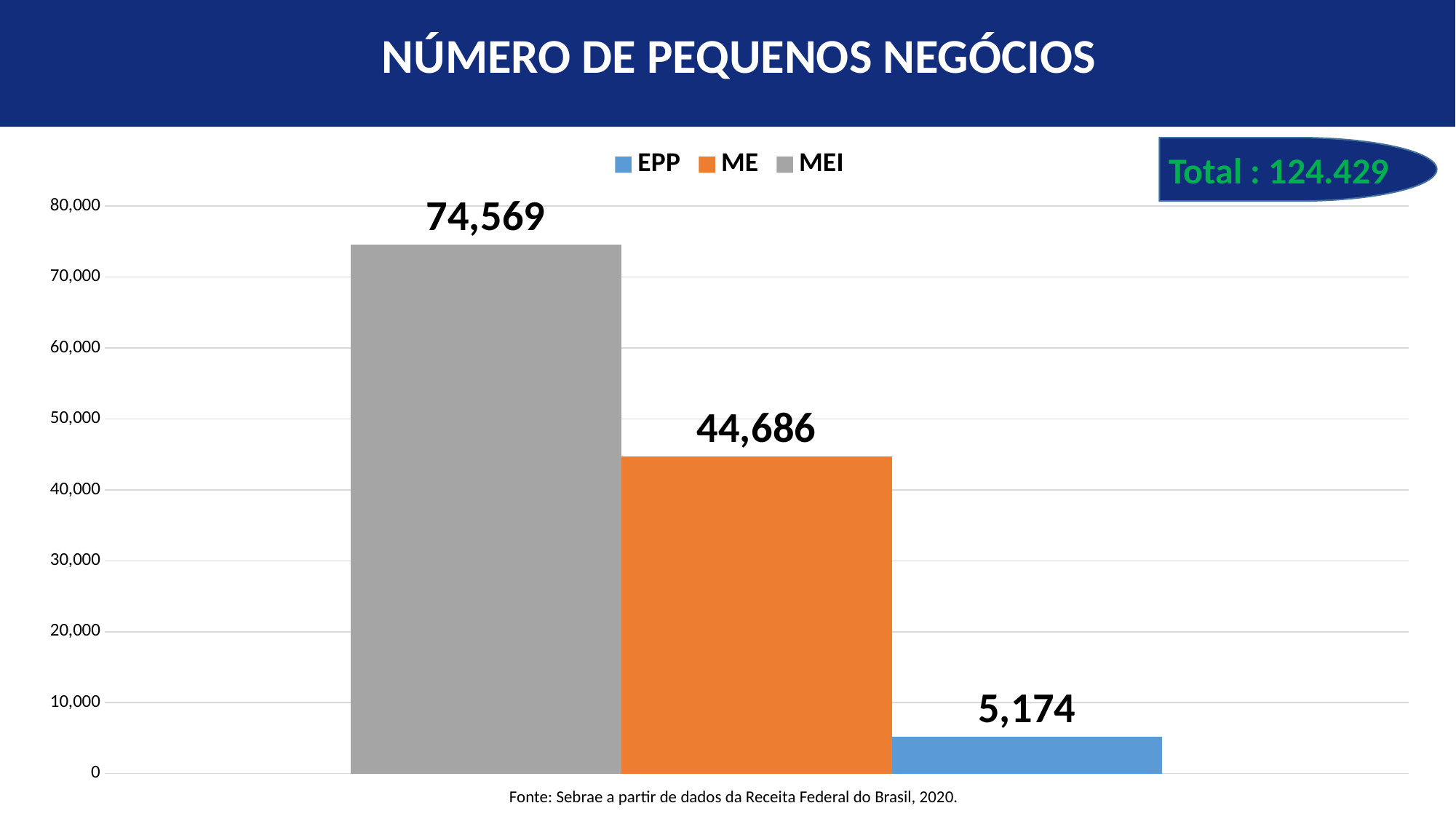
What is the difference between the values for MEI and ME? 29,883 What is the difference between the values for ME and EPP? 39,512 How many series does the legend list? 3 Which series has the highest value? MEI Which is larger, the value for ME or the value for EPP? ME Is the value for ME greater or less than 40,000? greater What is the value for EPP? 5,174 What is the value for ME? 44,686 What kind of chart is shown on the slide? bar chart What is the title of the chart? NÚMERO DE PEQUENOS NEGÓCIOS What is the value for MEI? 74,569 Which series has the lowest value? EPP